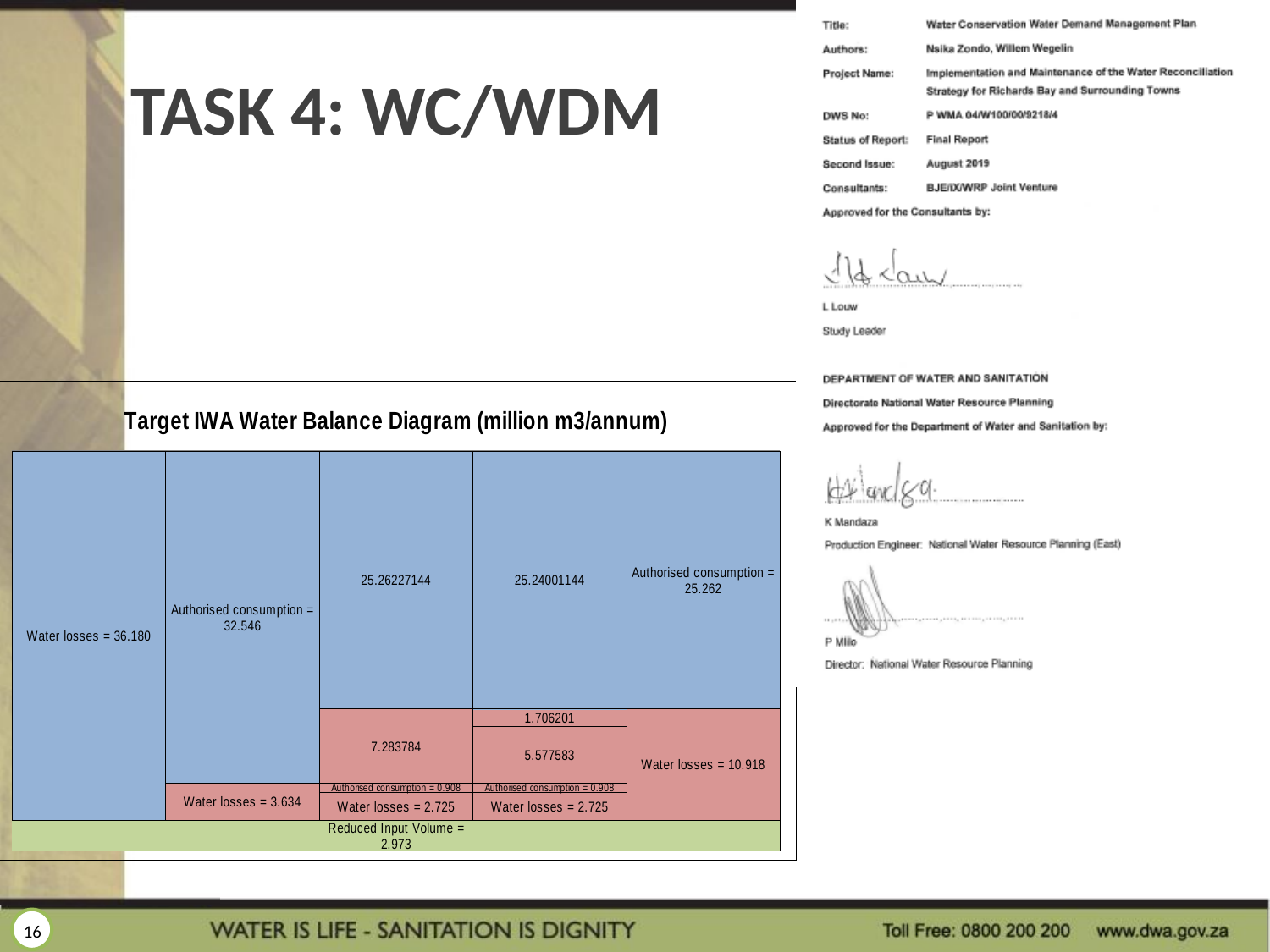
What is the value of Water losses in the leftmost column of the water balance diagram? 36.180 How many vertical columns make up the water balance diagram above the Reduced Input Volume bar? 5 What is the difference between Authorised consumption (25.262) and Water losses (10.918) in the rightmost column of the water balance diagram? 14.344 What is the total of the second column from the left of the water balance diagram (Authorised consumption 32.546 plus Water losses 3.634)? 36.180 What is the title of the diagram on the slide? Target IWA Water Balance Diagram (million m3/annum) What is the value of Authorised consumption in the rightmost column of the water balance diagram? 25.262 In the rightmost column of the water balance diagram, which is larger: Authorised consumption or Water losses? Authorised consumption What is the Reduced Input Volume shown at the bottom of the water balance diagram? 2.973 What is the value of Water losses in the rightmost column of the water balance diagram? 10.918 What is the value of Authorised consumption in the second column from the left of the water balance diagram? 32.546 What is the value of Water losses in the second column from the left of the water balance diagram? 3.634